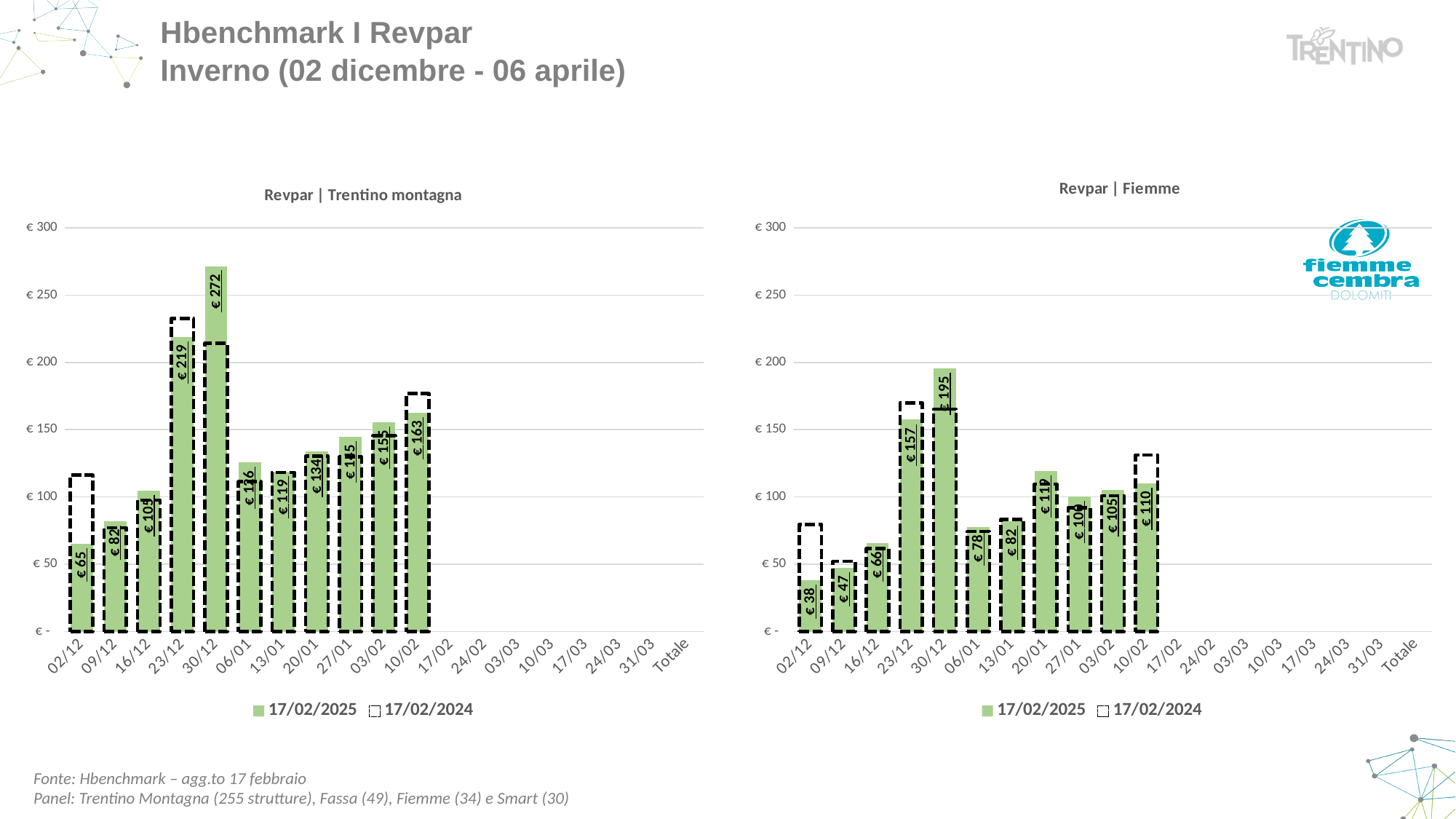
In the Revpar | Trentino montagna chart, is the 17/02/2024 value for 02/12 greater or less than 100? greater In the Revpar | Fiemme chart, what is the 17/02/2025 value for 30/12? € 195 In the Revpar | Fiemme chart, which 17/02/2025 value is larger, 23/12 or 30/12? 30/12 In the Revpar | Trentino montagna chart, which date has the highest 17/02/2025 value? 30/12 In the Revpar | Trentino montagna chart, what is the 17/02/2025 value for 30/12? € 272 What kind of chart is the Revpar | Trentino montagna chart? Bar chart In the Revpar | Fiemme chart, what is the difference between the 17/02/2025 values for 10/02 and 03/02? € 5 How many series does the legend of the Revpar | Fiemme chart list? 2 In the Revpar | Trentino montagna chart, what is the difference between the 17/02/2025 values for 30/12 and 23/12? € 53 In the Revpar | Trentino montagna chart, what is the 17/02/2025 value for 10/02? € 163 In the Revpar | Trentino montagna chart, which date has the lowest 17/02/2025 value? 02/12 In the Revpar | Fiemme chart, which date has the lowest 17/02/2025 value? 02/12